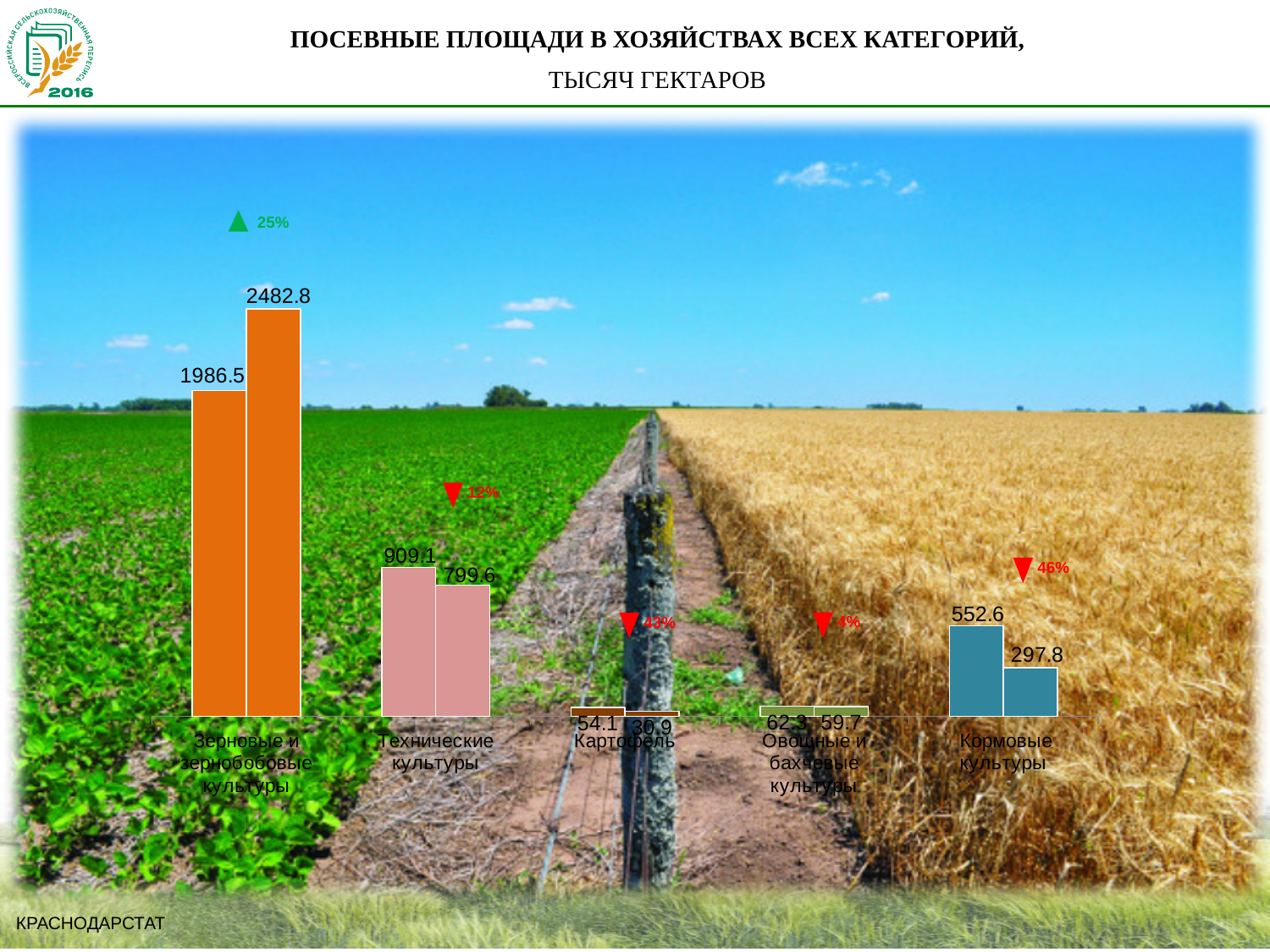
What is the difference between the right and left bars for Зерновые и зернобобовые культуры? 496.3 What is the difference between the left and right bars for Кормовые культуры? 254.8 What is the value of the left bar for Зерновые и зернобобовые культуры? 1986.5 What percentage change is shown above the bars for Кормовые культуры? 46% decrease How many categories are shown on the chart? 5 Which is larger for Технические культуры: the left bar or the right bar? the left bar What is the value of the left bar for Кормовые культуры? 552.6 Which category has the lowest right-bar value on the chart? Картофель What is the value of the right bar for Зерновые и зернобобовые культуры? 2482.8 What is the value of the right bar for Картофель? 30.9 What is the value of the right bar for Технические культуры? 799.6 Which category has the highest values on the chart? Зерновые и зернобобовые культуры